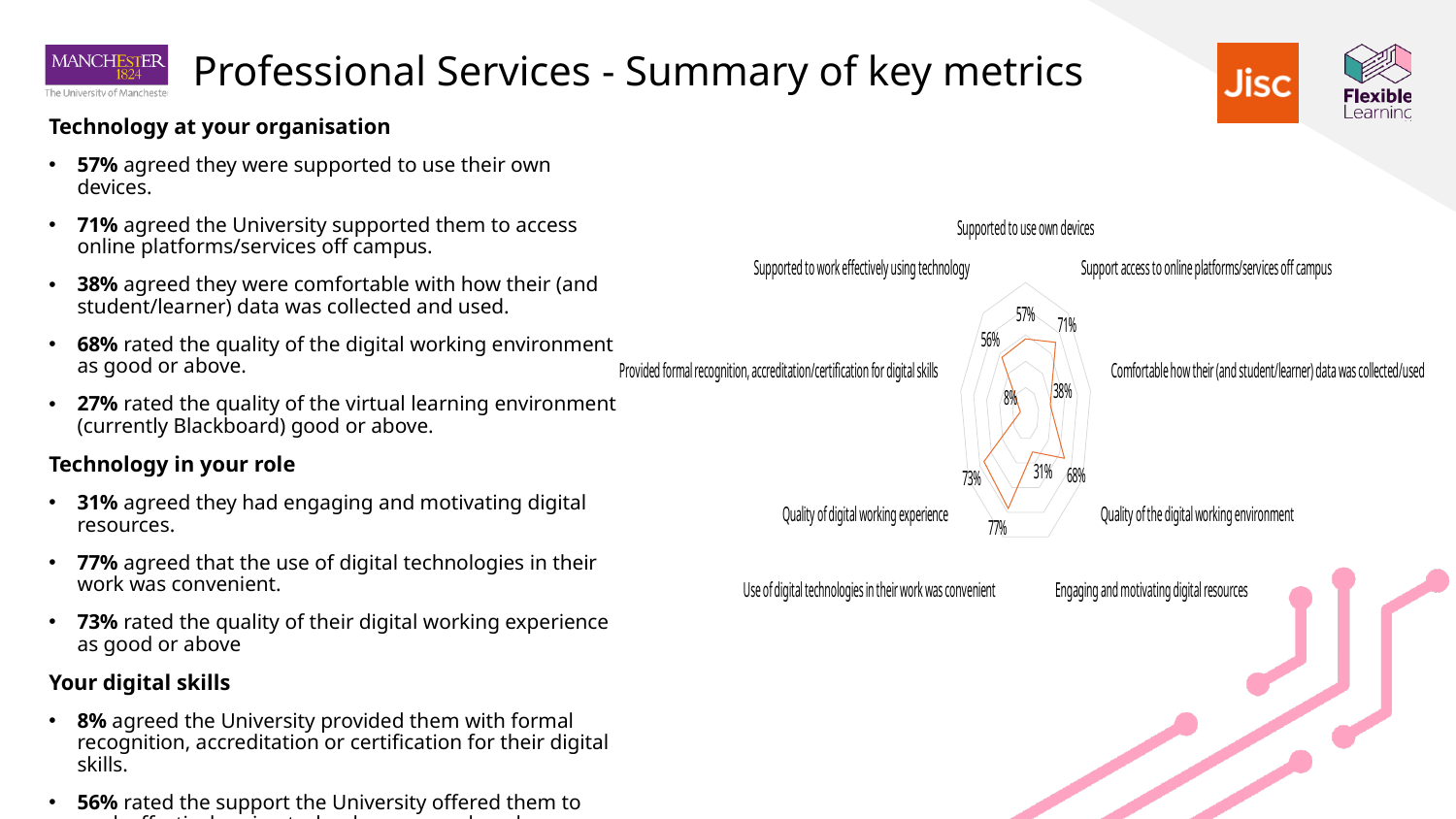
Which category has the highest value in the radar chart? Use of digital technologies in their work was convenient Which category has the lowest value in the radar chart? Provided formal recognition, accreditation/certification for digital skills What is the value for 'Support access to online platforms/services off campus' in the radar chart? 71% What is the value for 'Use of digital technologies in their work was convenient' in the radar chart? 77% What is the value for 'Supported to use own devices' in the radar chart? 57% What is the difference between the values for 'Support access to online platforms/services off campus' and 'Supported to use own devices' in the radar chart? 14% What kind of chart is shown on the slide? Radar chart How many categories are plotted in the radar chart? 9 What is the value for 'Provided formal recognition, accreditation/certification for digital skills' in the radar chart? 8% Which is larger in the radar chart: 'Comfortable how their (and student/learner) data was collected/used' or 'Engaging and motivating digital resources'? Comfortable how their (and student/learner) data was collected/used What is the difference between the values for 'Quality of digital working experience' and 'Quality of the digital working environment' in the radar chart? 5% What is the title of the slide containing the radar chart? Professional Services - Summary of key metrics